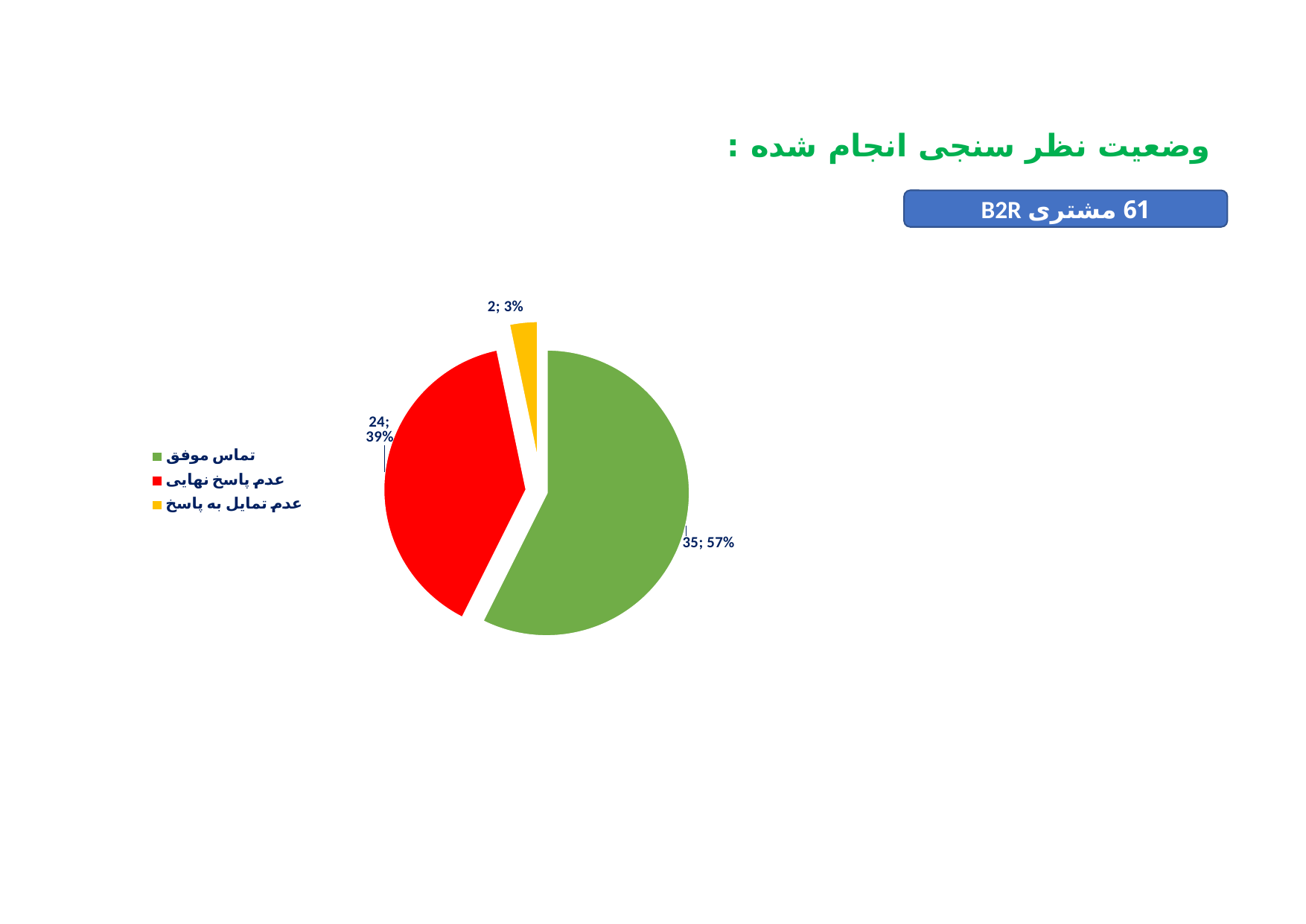
Which slice of the pie chart is the smallest? عدم تمایل به پاسخ How many slices does the pie chart have? 3 What kind of chart is shown on the slide? pie chart How many entries does the legend of the pie chart list? 3 What is the difference between the counts for تماس موفق and عدم پاسخ نهایی? 11 What is the count shown for the slice labelled تماس موفق? 35 What percentage share does the slice labelled عدم پاسخ نهایی have? 39% Which slice of the pie chart is the largest? تماس موفق Which colour represents عدم پاسخ نهایی in the pie chart? red What percentage share does the slice labelled تماس موفق have? 57% What is the count shown for the slice labelled عدم تمایل به پاسخ? 2 What is the count shown for the slice labelled عدم پاسخ نهایی? 24